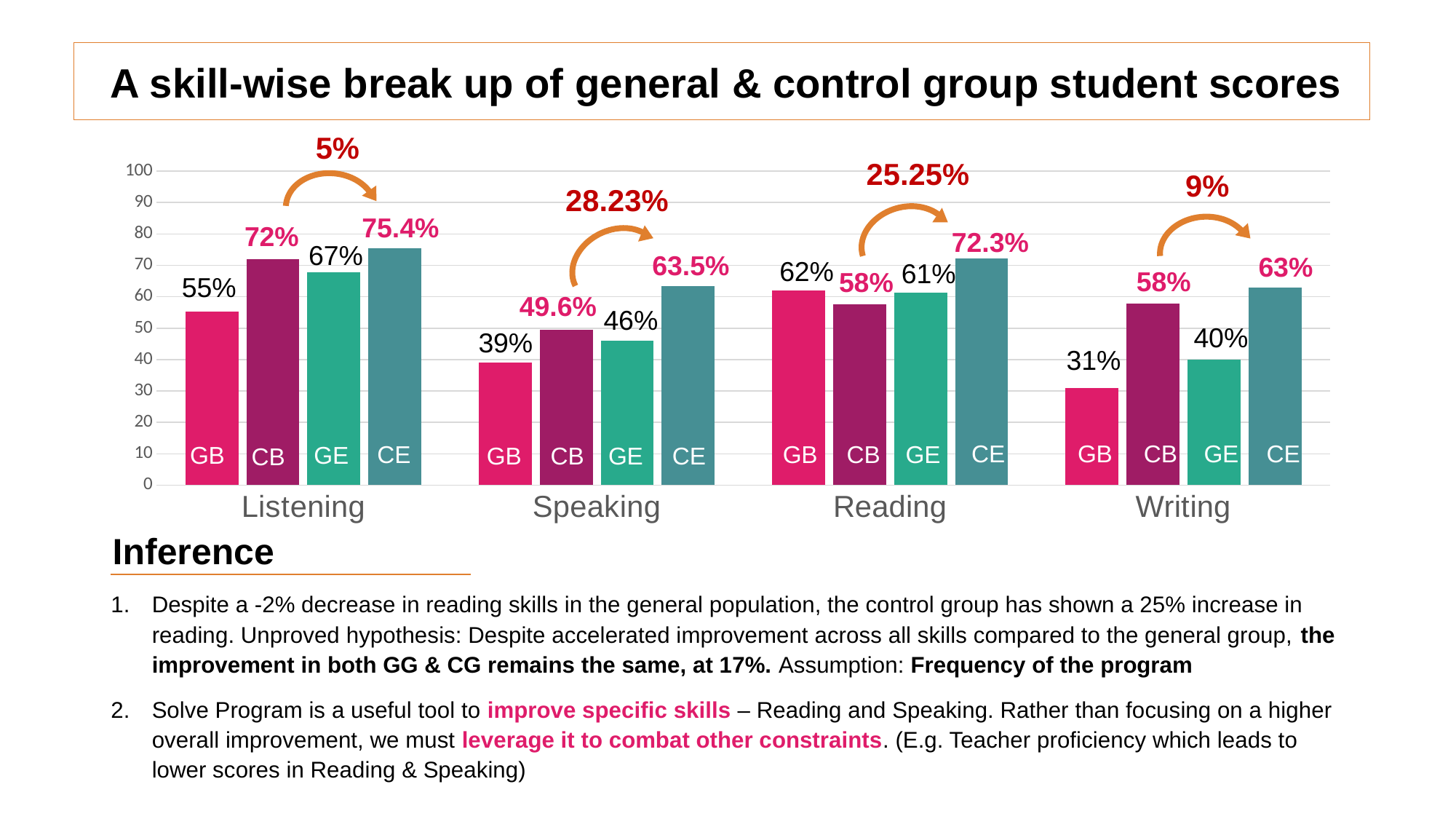
What is the value of the GE bar for Reading? 61% What percentage change is shown by the arrow above the Reading group? 25.25% What is the value of the CE bar for Listening? 75.4% What type of chart is shown on the slide? Bar chart Which is larger for Reading, the GB bar or the CB bar? GB What is the value of the GB bar for Writing? 31% How many skill categories are shown on the x axis? 4 What is the difference between the CE and CB values for Speaking? 13.9% What is the value of the CB bar for Speaking? 49.6% Which skill has the highest CE value? Listening Which skill has the lowest GB value? Writing What is the title of the chart? A skill-wise break up of general & control group student scores